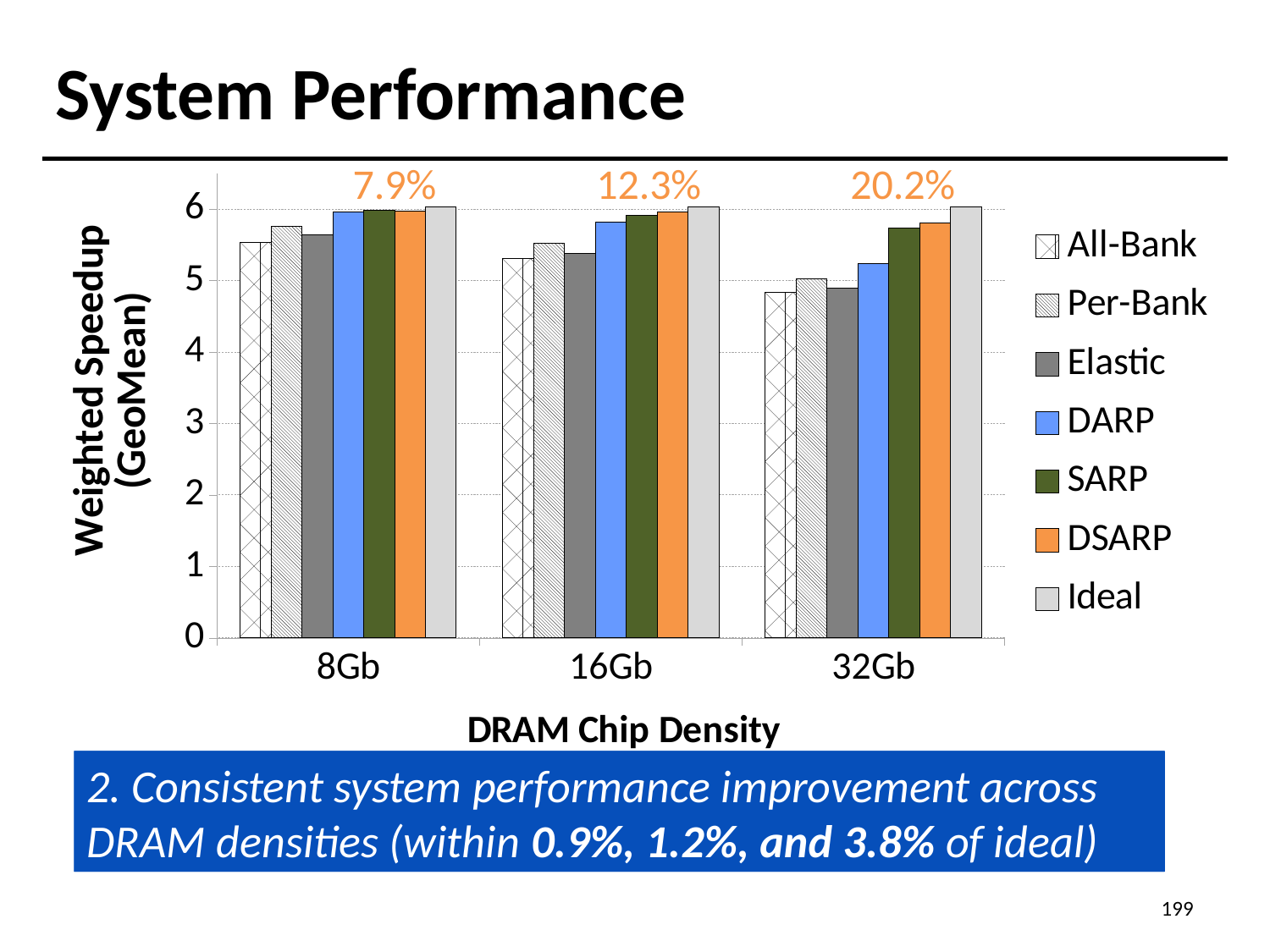
How many DRAM chip density categories are shown on the x axis? 3 Is the All-Bank value at 8Gb greater or less than 5? greater Is the DARP value at 32Gb greater or less than 5? greater What kind of chart is shown on the slide? bar chart Do the All-Bank values rise or fall as DRAM chip density increases from 8Gb to 32Gb? fall Is the All-Bank value at 32Gb greater or less than 5? less What percentage is printed above the 8Gb group of bars? 7.9% At 32Gb, which is larger: the DARP bar or the All-Bank bar? DARP What percentage is printed above the 32Gb group of bars? 20.2% Which series has the highest bar at 32Gb? Ideal What percentage is printed above the 16Gb group of bars? 12.3% How many series does the legend list? 7